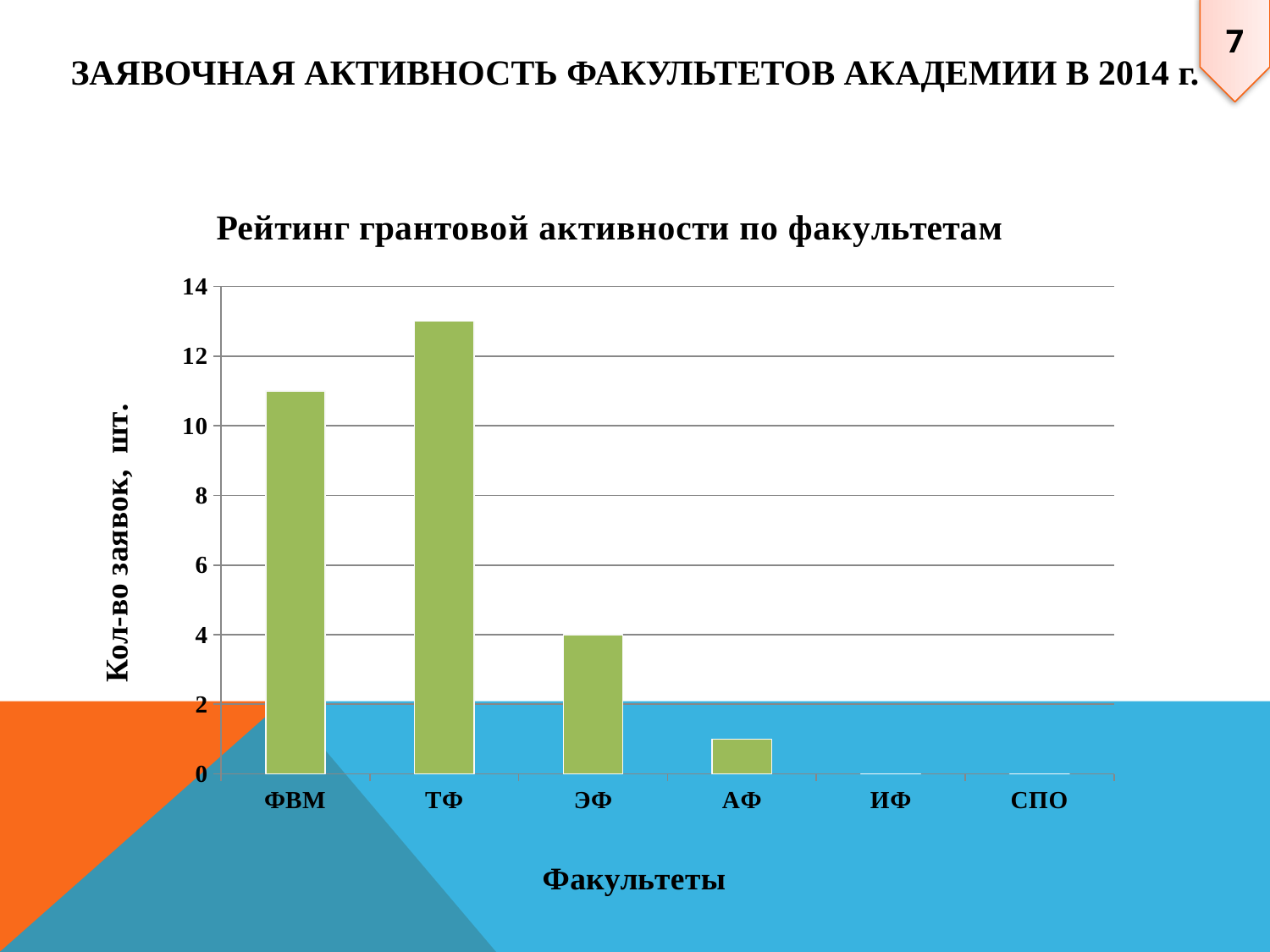
What kind of chart is shown on the slide? bar chart What is the number of applications for ЭФ? 4 How many faculties are shown on the x axis of the chart? 6 Is the value for ТФ greater or less than 12? greater Which has more applications, ФВМ or ТФ? ТФ Is the value for АФ greater or less than 2? less Which faculty has the highest number of applications? ТФ Is the value for ФВМ greater or less than 10? greater What is the title of the chart? Рейтинг грантовой активности по факультетам What is the number of applications for СПО? 0 What is the number of applications for ИФ? 0 Do the values generally rise or fall from ТФ to СПО along the x axis? fall